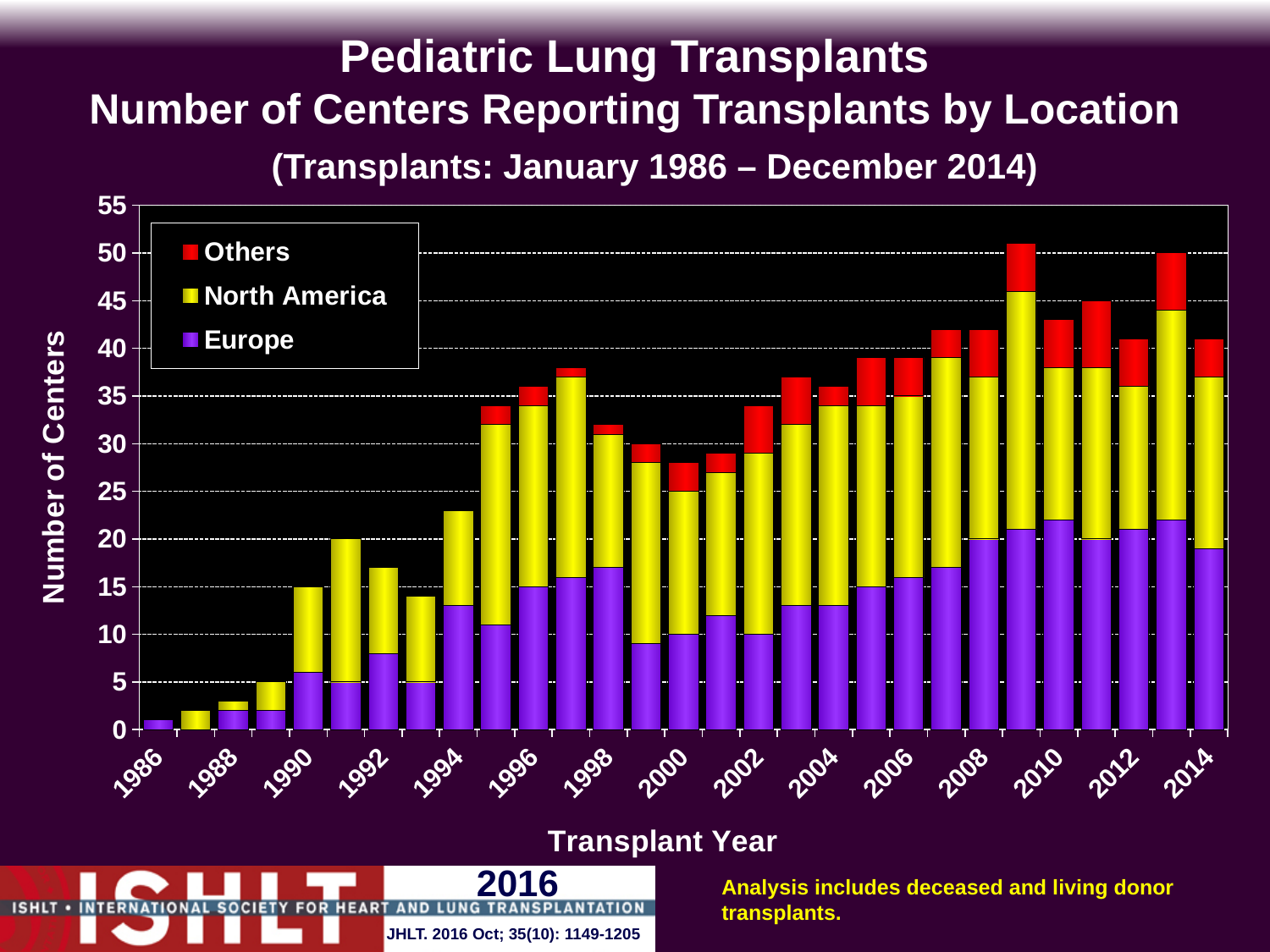
What kind of chart is shown on the slide? Stacked bar chart How many transplant years (bars) are plotted on the chart? 29 Is the total number of centers for 1986 greater or less than 5? less Which transplant year has the highest total number of centers? 2009 Does the total number of centers rise or fall from 1986 to 1990? rise Is the total number of centers for 2014 greater or less than 35? greater Which series are listed in the legend? Others, North America, Europe How many series does the legend list? 3 What is the label of the y axis? Number of Centers Which year has a larger total number of centers, 2009 or 2010? 2009 Is the total number of centers for 2009 greater or less than 45? greater Which transplant year has the lowest total number of centers? 1986